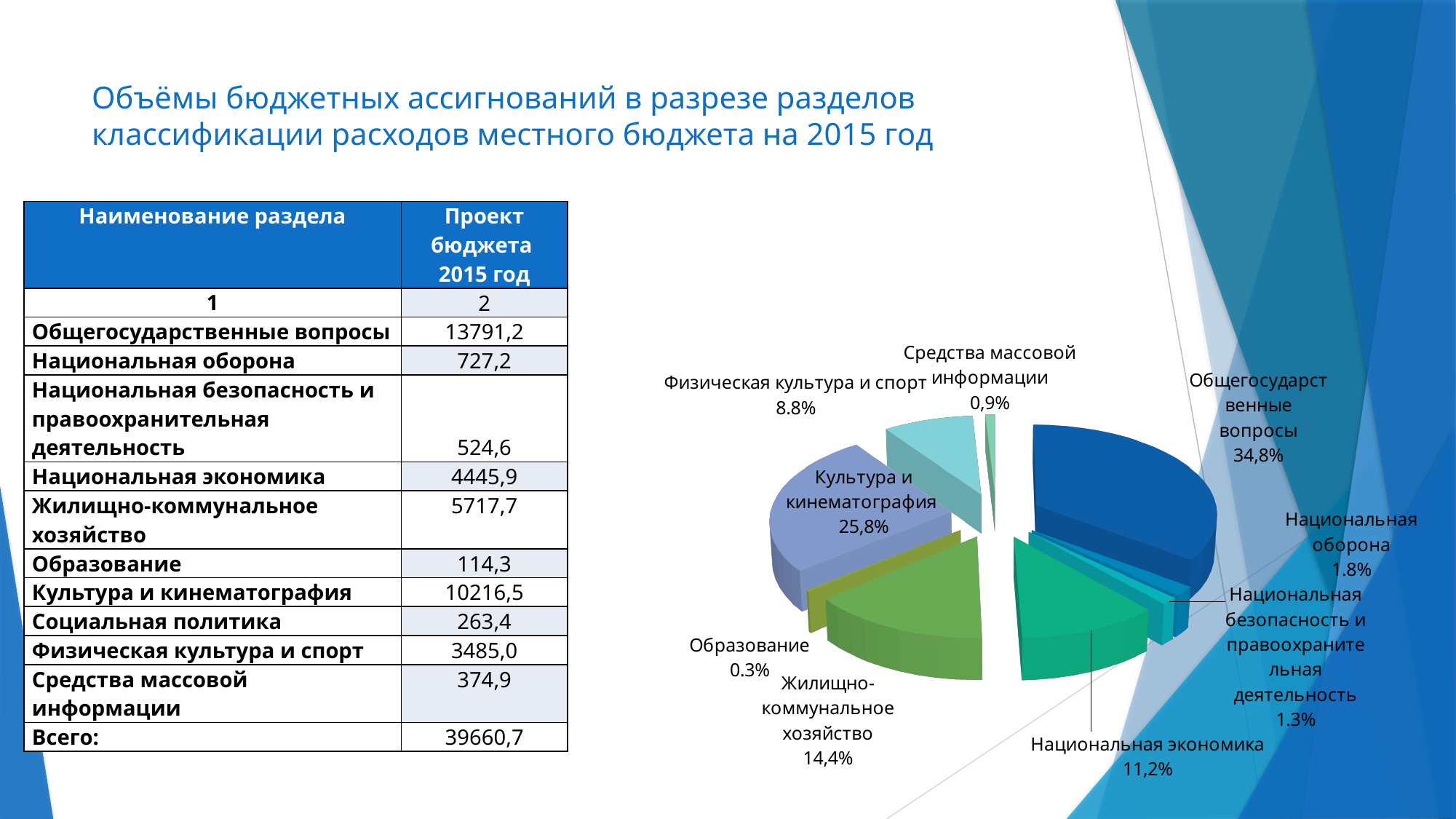
Which has the larger share in the pie chart: Культура и кинематография or Жилищно-коммунальное хозяйство? Культура и кинематография What kind of chart is shown on the slide? Pie chart What share of the pie does Общегосударственные вопросы have? 34,8% What percentage is shown for Средства массовой информации in the pie chart? 0,9% What percentage is shown for Жилищно-коммунальное хозяйство in the pie chart? 14,4% What percentage is shown for Национальная экономика in the pie chart? 11,2% What percentage is shown for Национальная безопасность и правоохранительная деятельность in the pie chart? 1,3% Which labelled category has the smallest share in the pie chart? Образование Which category has the largest slice of the pie chart? Общегосударственные вопросы What percentage is shown for Физическая культура и спорт in the pie chart? 8.8% By how many percentage points does the share of Жилищно-коммунальное хозяйство exceed that of Национальная экономика? 3,2 What share of the pie does Культура и кинематография have? 25,8%